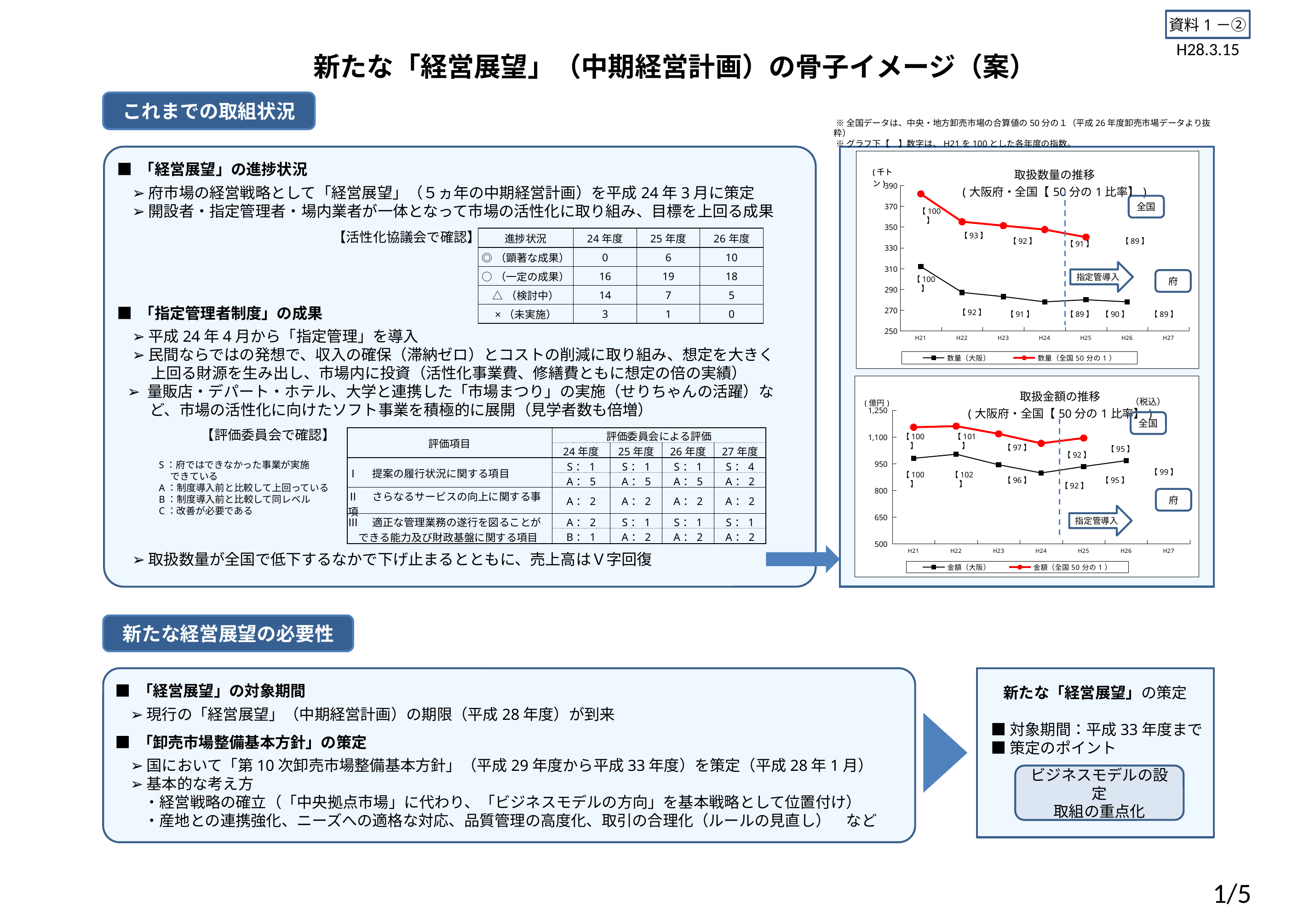
How many series does the legend of the 取扱金額の推移 chart list? 2 In the 取扱金額の推移 chart, is the value for 金額（全国50分の1） at H21 greater or less than 1,100? greater In the 取扱数量の推移 chart, does the 数量（全国50分の1） line rise or fall from H21 to H25? fall In the 取扱金額の推移 chart, what colour is the 金額（全国50分の1） line? red In the 取扱数量の推移 chart, how many year labels are shown on the x axis? 7 In the 取扱金額の推移 chart, what index number (H21=100) is printed for 金額（大阪） at H26? 99 In the 取扱数量の推移 chart, which series is higher at H23, 数量（大阪） or 数量（全国50分の1）? 数量（全国50分の1） What kind of chart is the 取扱数量の推移 chart? line chart In the 取扱数量の推移 chart, is the value for 数量（大阪） at H24 greater or less than 290? less In the 取扱数量の推移 chart, is the value for 数量（全国50分の1） at H21 greater or less than 370? greater In the 取扱数量の推移 chart, what index number (H21=100) is printed for 数量（全国50分の1） at H25? 89